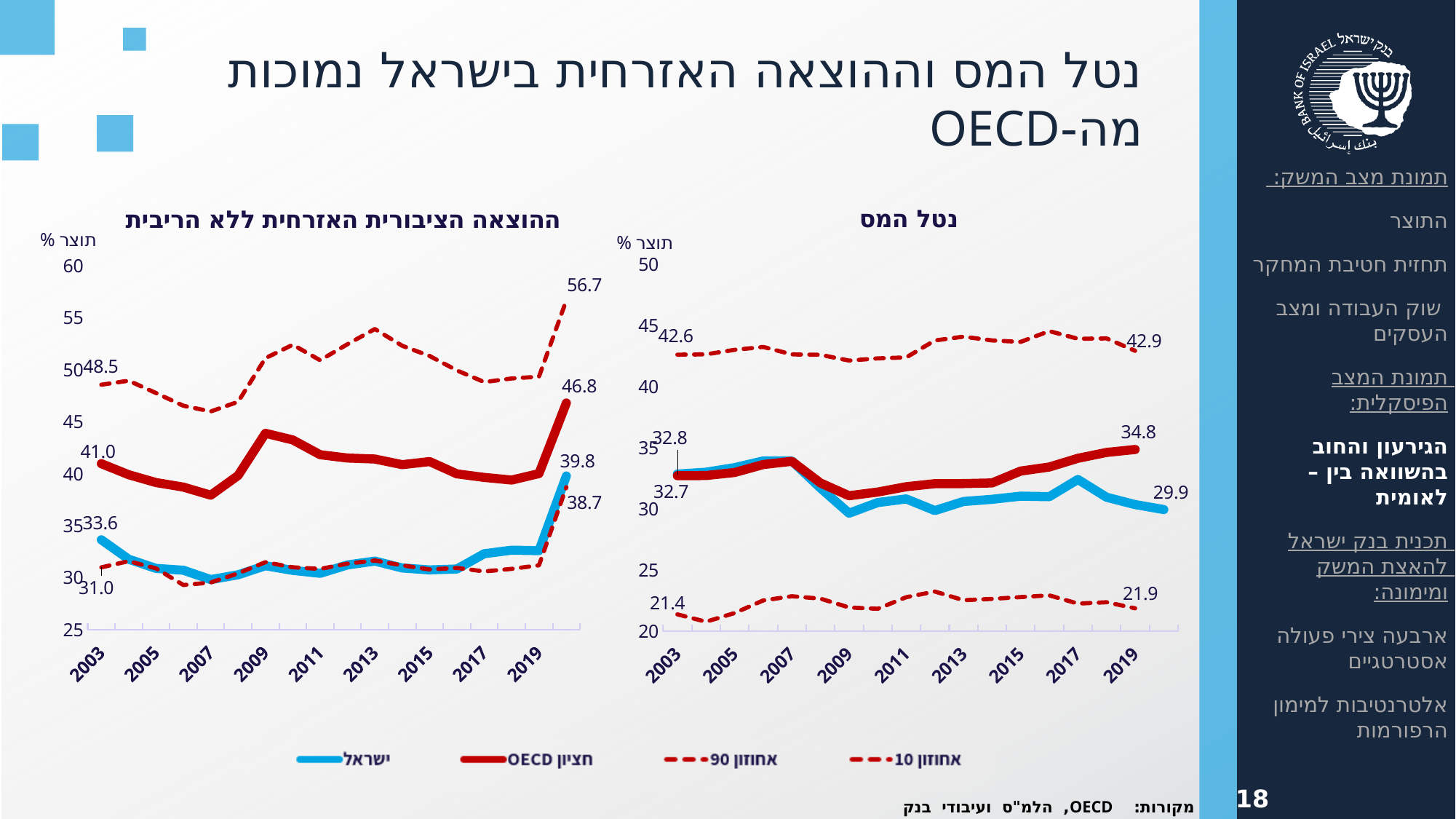
In the right chart (נטל המס), what is the final labelled value for the OECD median (חציון OECD) series? 34.8 In the right chart (נטל המס), at the end of the period, which is larger: the OECD median or Israel? OECD median (חציון OECD) In the left chart (ההוצאה הציבורית האזרחית ללא הריבית), what is the first labelled value for Israel (ישראל)? 33.6 In the right chart (נטל המס), what is the final labelled value of the 90th percentile (אחוזון 90) series? 42.9 In the right chart (נטל המס), what is the first labelled value of the 10th percentile (אחוזון 10) series? 21.4 In the right chart (נטל המס), is the final value for Israel greater or less than 30? less In the left chart (ההוצאה הציבורית האזרחית ללא הריבית), what is the difference between the final labelled values of the 90th percentile (56.7) and the OECD median (46.8)? 9.9 What type of chart is used on this slide? line chart In the left chart (ההוצאה הציבורית האזרחית ללא הריבית), what is the final labelled value for the OECD median (חציון OECD)? 46.8 In the right chart (נטל המס), what is the final labelled value for Israel (ישראל)? 29.9 How many series does the legend list? 4 In the left chart (ההוצאה הציבורית האזרחית ללא הריבית), which series has the highest final labelled value? אחוזון 90 (90th percentile)